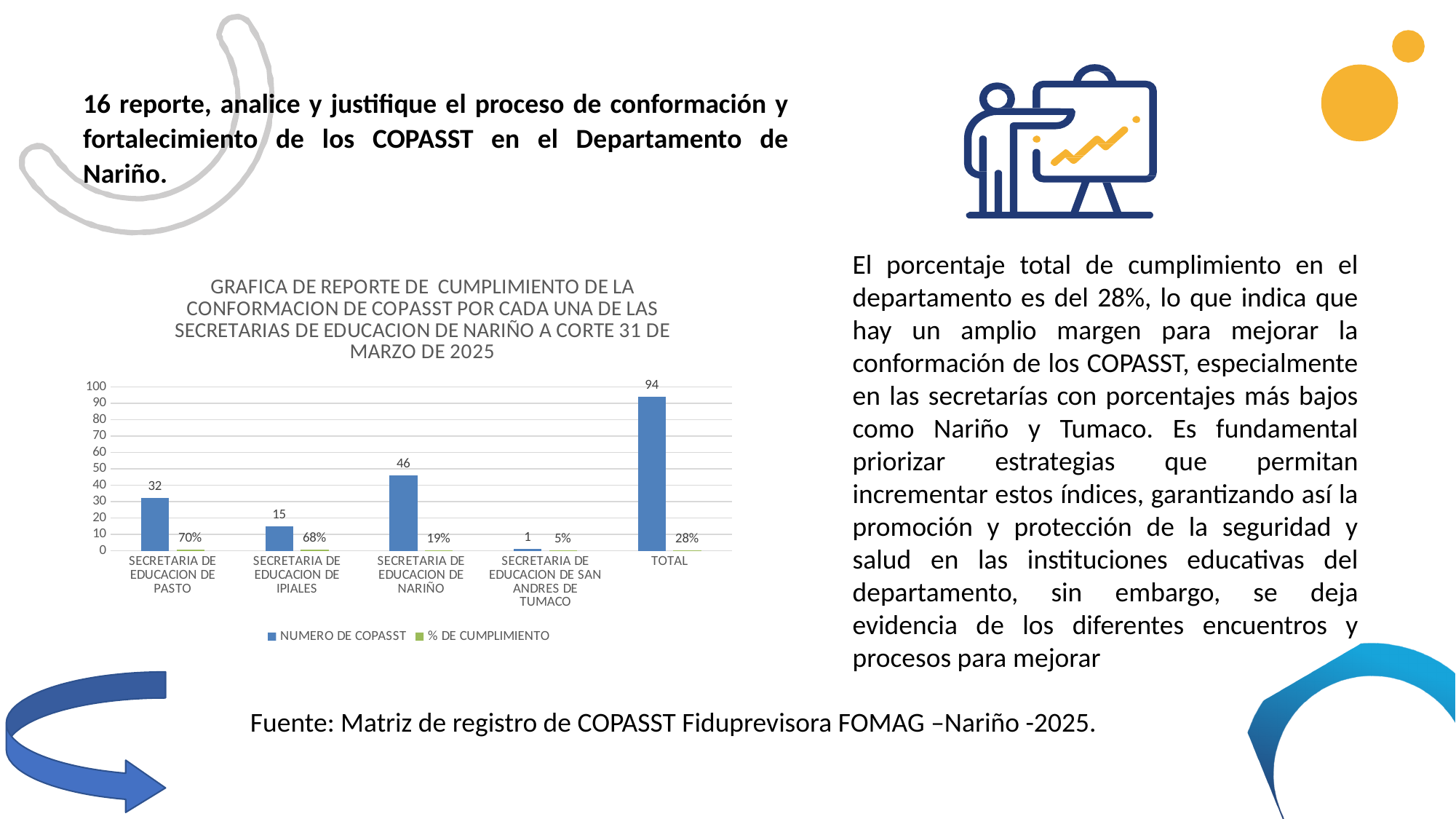
What is the NUMERO DE COPASST for TOTAL? 94 Which has a higher % DE CUMPLIMIENTO, SECRETARIA DE EDUCACION DE PASTO or SECRETARIA DE EDUCACION DE NARIÑO? SECRETARIA DE EDUCACION DE PASTO Which category has the lowest % DE CUMPLIMIENTO? SECRETARIA DE EDUCACION DE SAN ANDRES DE TUMACO What type of chart is shown on the slide? Bar chart What is the difference in NUMERO DE COPASST between SECRETARIA DE EDUCACION DE NARIÑO and SECRETARIA DE EDUCACION DE PASTO? 14 Which secretaría (excluding TOTAL) has the highest NUMERO DE COPASST? SECRETARIA DE EDUCACION DE NARIÑO What is the NUMERO DE COPASST for SECRETARIA DE EDUCACION DE NARIÑO? 46 What is the % DE CUMPLIMIENTO for SECRETARIA DE EDUCACION DE SAN ANDRES DE TUMACO? 5% How many series does the chart legend list? 2 What is the % DE CUMPLIMIENTO for SECRETARIA DE EDUCACION DE IPIALES? 68% What is the NUMERO DE COPASST for SECRETARIA DE EDUCACION DE PASTO? 32 How many categories are shown on the x axis of the chart? 5